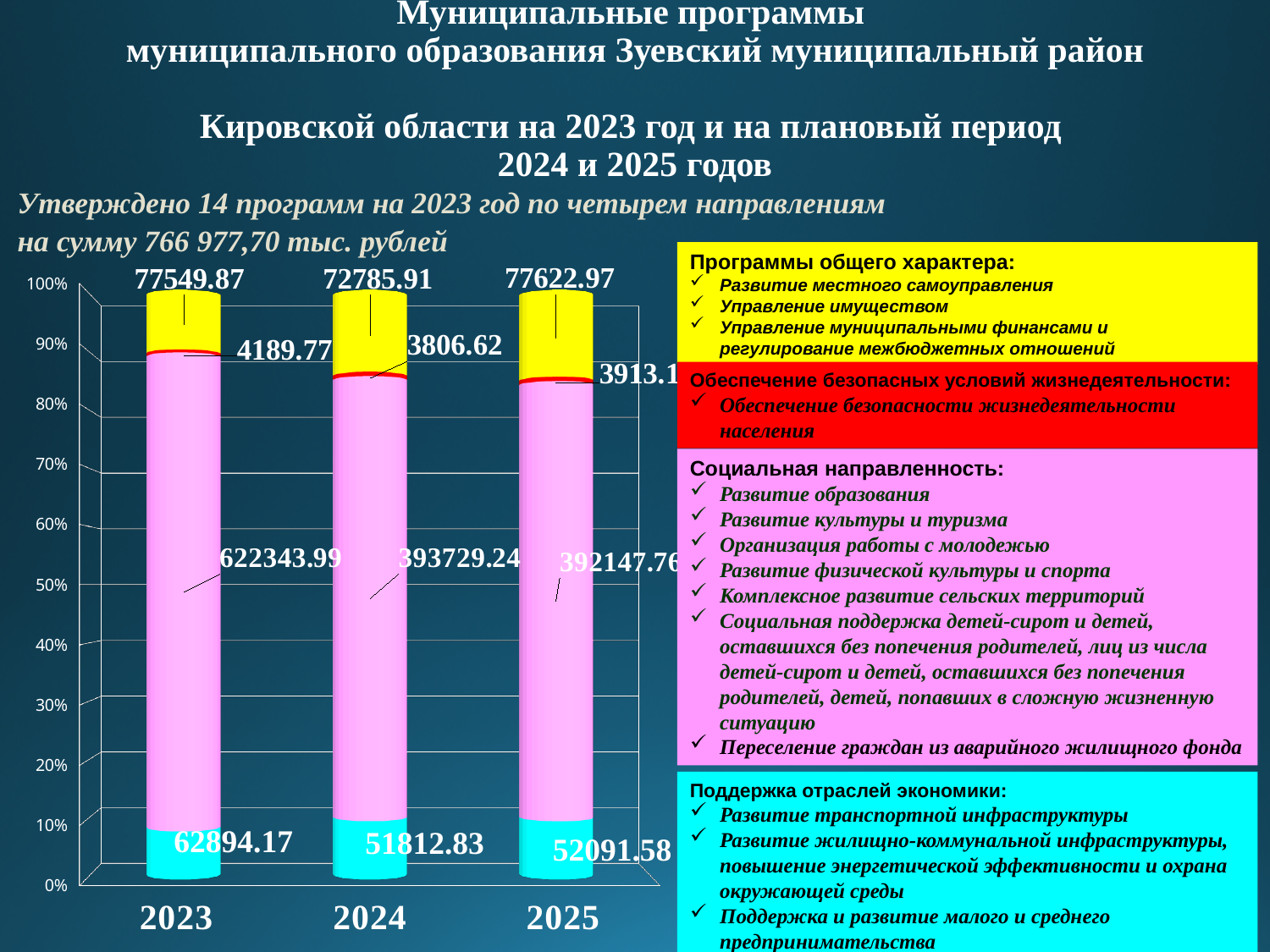
How many years are shown on the x axis of the chart? 3 How many coloured segments does each bar contain? 4 Which year has the larger pink (social) segment value, 2024 or 2025? 2024 What kind of chart is shown on the slide? stacked bar chart Is the share of the pink segment in the 2025 bar greater or less than 50%? greater What is the value of the pink (social) segment for 2023? 622343.99 What is the value of the red segment for 2023? 4189.77 Which year has the highest value for the yellow (top) segment? 2025 What is the value of the cyan (bottom) segment for 2025? 52091.58 Which year has the lowest value for the cyan (bottom) segment? 2024 What is the value of the yellow (top) segment for 2024? 72785.91 What is the difference between the cyan (bottom) segment values for 2023 and 2024? 11081.34